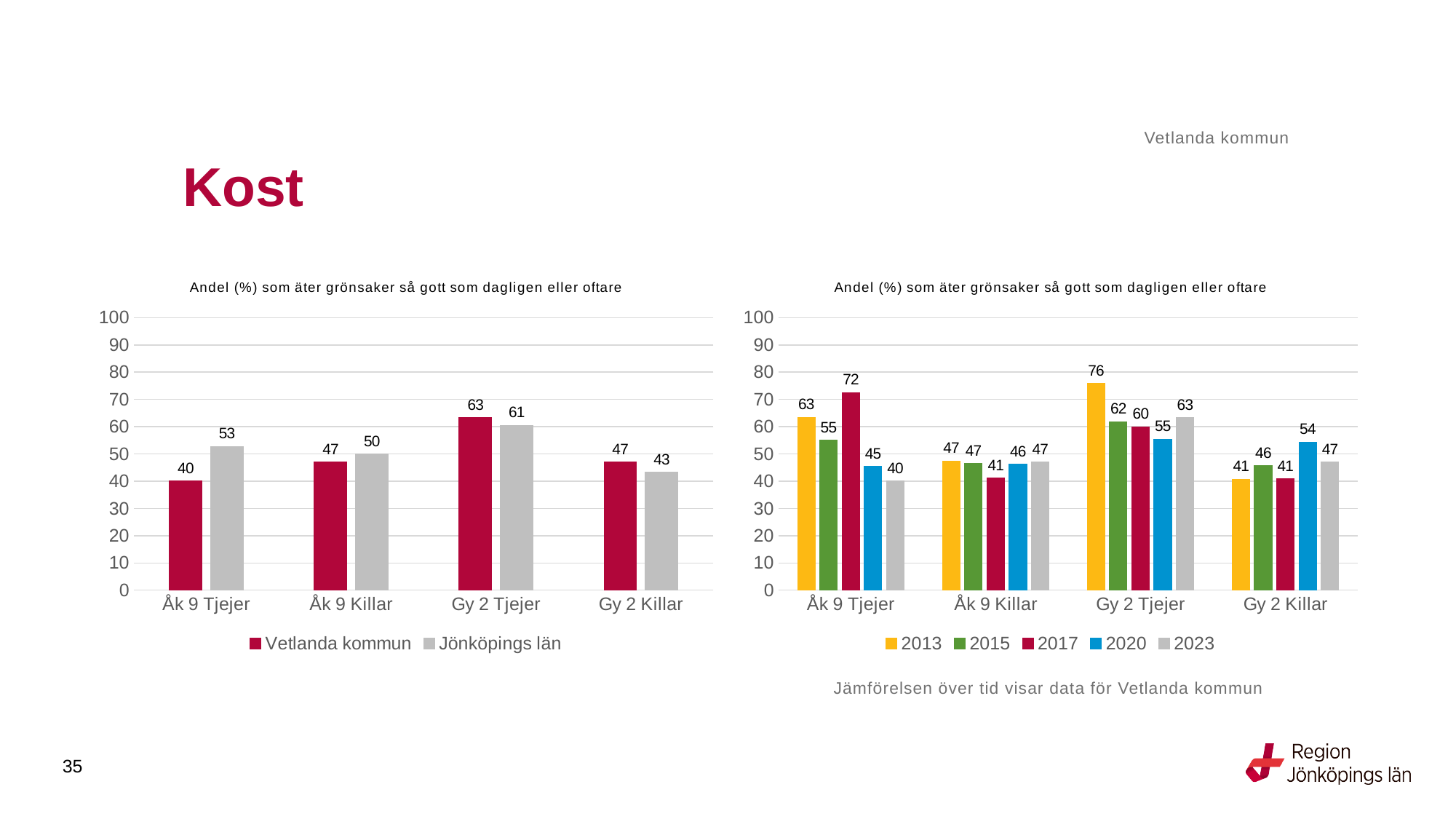
How many series does the legend of the left chart list? 2 How many series does the legend of the right chart list? 5 In the left chart, which is larger for Gy 2 Killar: Vetlanda kommun or Jönköpings län? Vetlanda kommun In the left chart, what is the difference between Jönköpings län and Vetlanda kommun for Åk 9 Tjejer? 13 In the right chart, what is the value for 2017 for Åk 9 Tjejer? 72 In the right chart, what is the difference between 2020 and 2017 for Gy 2 Killar? 13 What kind of chart is the right chart? Bar chart In the right chart, which year has the lowest value for Åk 9 Tjejer? 2023 In the left chart, what is the value for Vetlanda kommun for Åk 9 Tjejer? 40 In the left chart, which category has the highest value for Vetlanda kommun? Gy 2 Tjejer In the left chart, what is the value for Jönköpings län for Gy 2 Killar? 43 In the right chart, what is the value for 2013 for Gy 2 Tjejer? 76